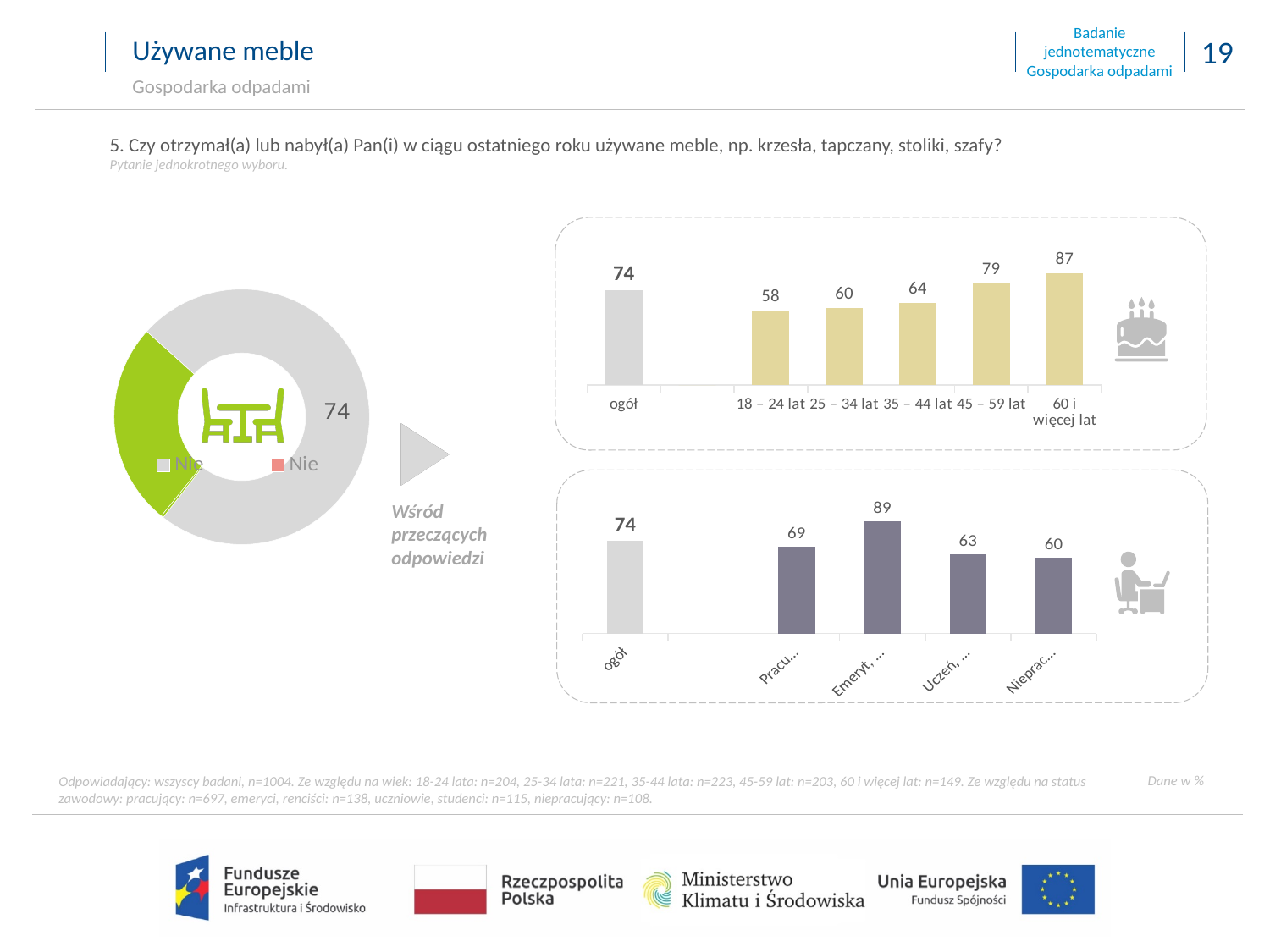
In the top right bar chart (by age), how many bars are plotted? 6 In the top right bar chart (by age), what is the value for 18 – 24 lat? 58 In the bottom right bar chart (by occupational status), what is the lowest value shown? 60 In the top right bar chart (by age), what is the difference between the value for 60 i więcej lat and the value for 18 – 24 lat? 29 In the top right bar chart (by age), which age group has the lowest value? 18 – 24 lat In the bottom right bar chart (by occupational status), which is larger: the value for ogół or the value for the second bar (Pracu...)? ogół In the bottom right bar chart (by occupational status), what is the highest value shown? 89 In the bottom right bar chart (by occupational status), what is the value for ogół? 74 In the top right bar chart (by age), which age group has the highest value? 60 i więcej lat What value is printed next to the donut chart on the left? 74 In the top right bar chart (by age), do the values rise or fall from 18 – 24 lat to 60 i więcej lat? rise In the top right bar chart (by age), what is the value for 60 i więcej lat? 87